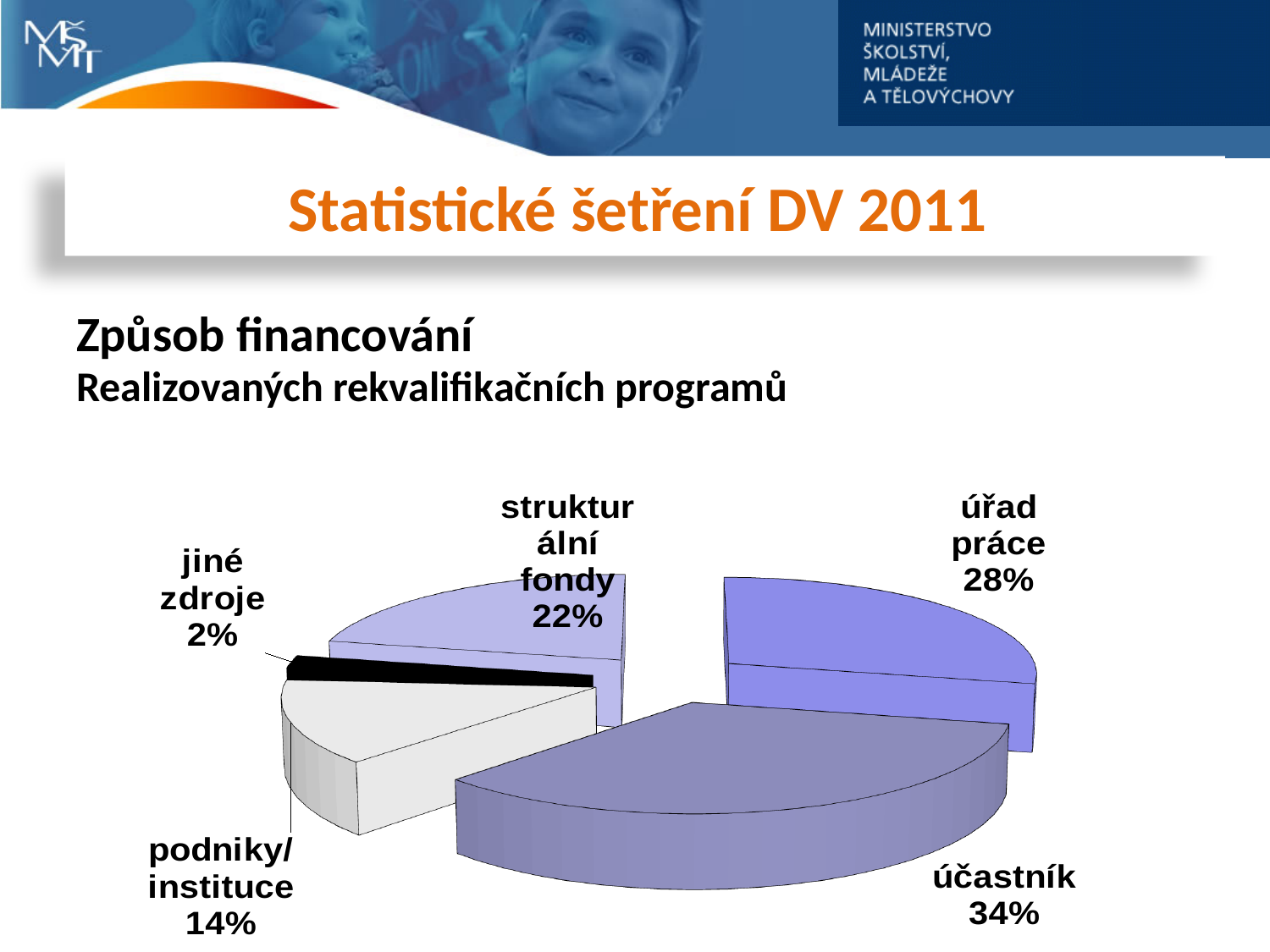
What is the combined share of 'úřad práce' and 'strukturální fondy'? 50% Which is larger, the share for 'strukturální fondy' or for 'podniky/instituce'? strukturální fondy What share of the pie does 'jiné zdroje' have? 2% What share of the pie does 'strukturální fondy' have? 22% What share of the pie does 'úřad práce' have? 28% Which category has the largest slice of the pie? účastník What kind of chart is shown on the slide? pie chart What share of the pie does 'účastník' have? 34% What is the difference in percentage points between 'účastník' and 'úřad práce'? 6 What share of the pie does 'podniky/instituce' have? 14% Which category has the smallest slice of the pie? jiné zdroje How many slices does the pie chart have? 5